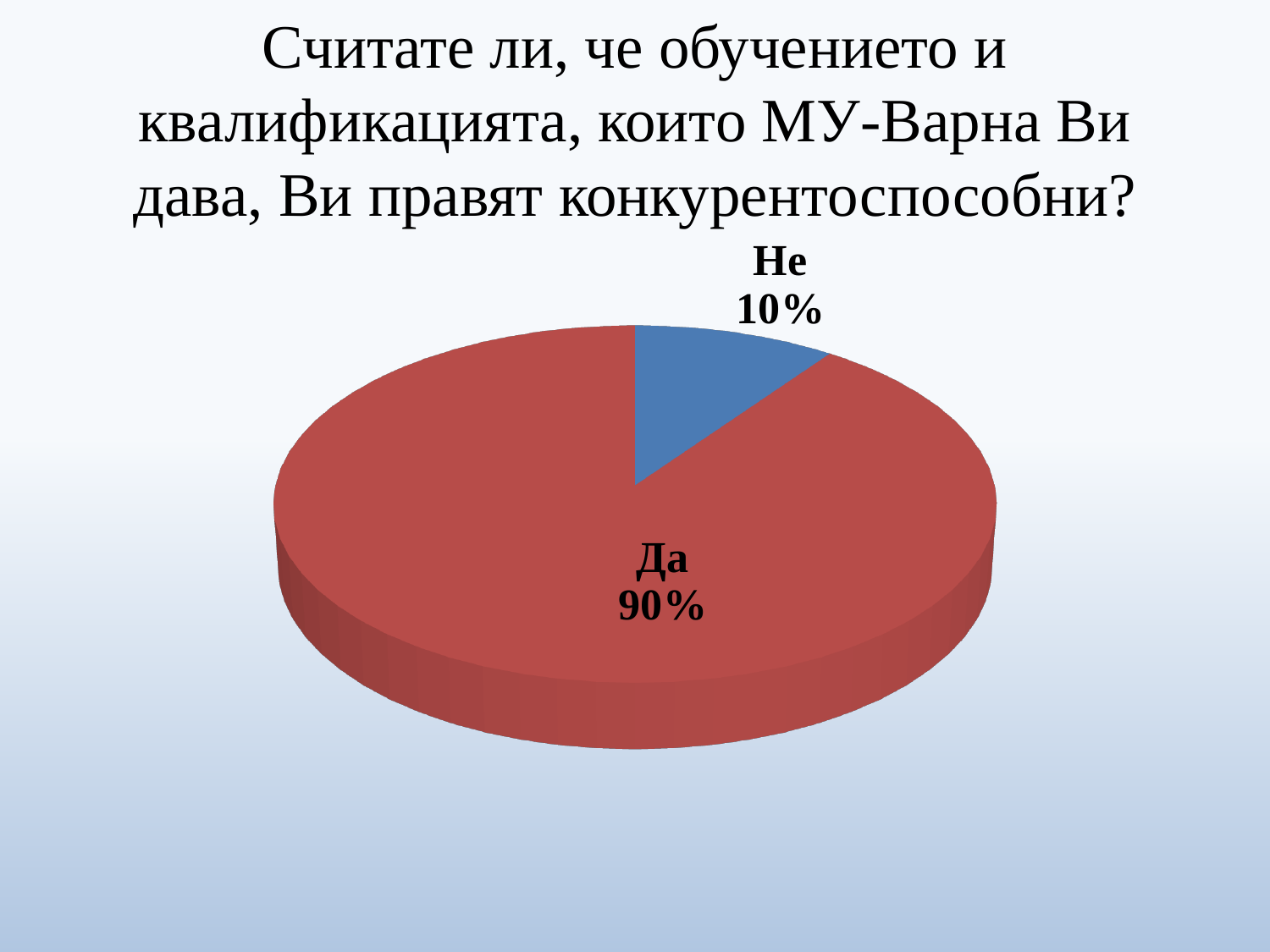
Which slice is larger, "Да" or "Не"? Да Which category has the smallest slice of the pie? Не What kind of chart is shown on the slide? Pie chart How many slices does the pie chart have? 2 What colour is the "Да" slice? Red What colour is the "Не" slice? Blue Which category has the largest slice of the pie? Да What is the difference in percentage points between the "Да" and "Не" slices? 80 What share of the pie does "Да" represent? 90% What share of the pie does "Не" represent? 10%